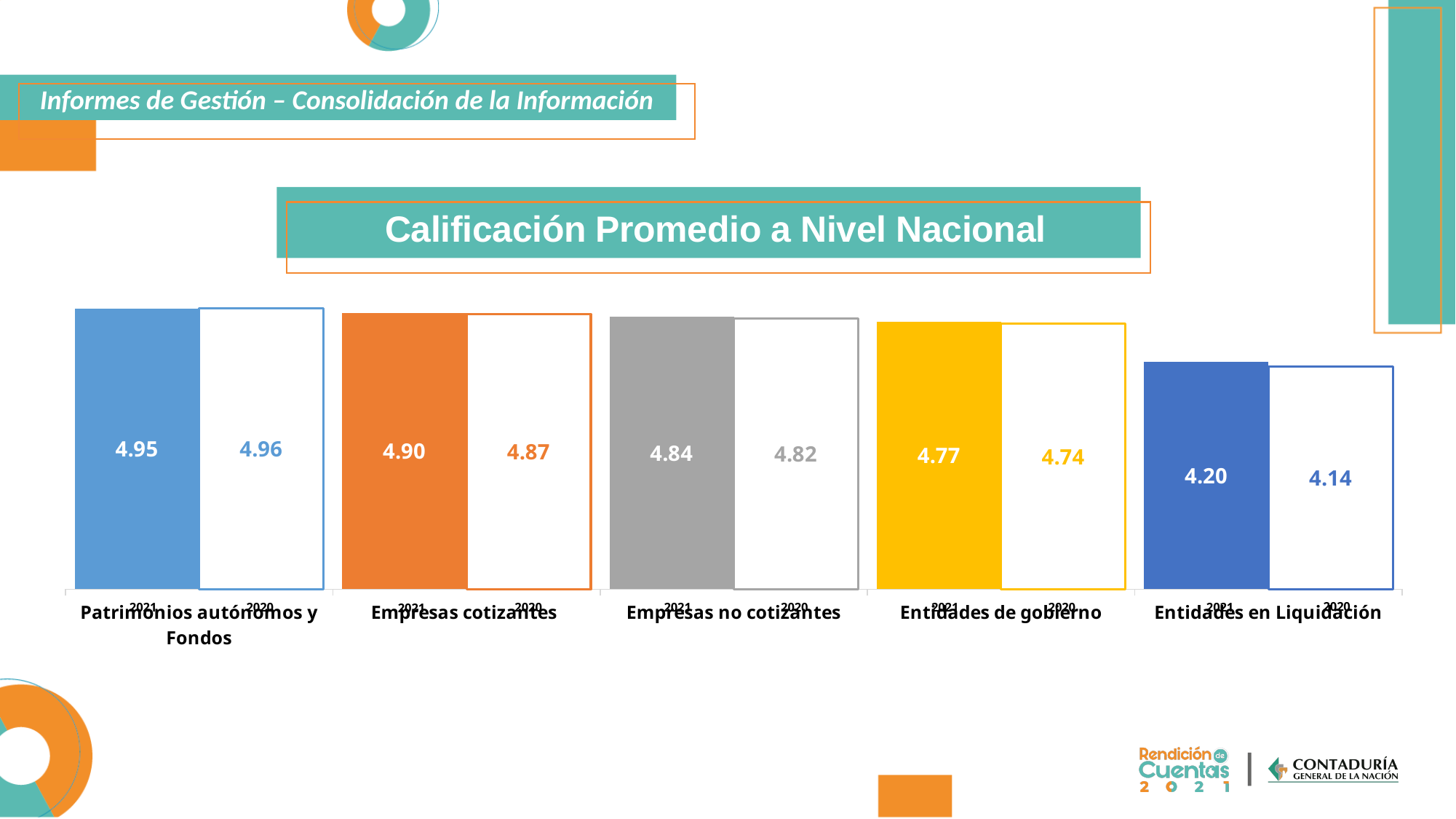
How many categories are shown on the x axis? 5 What is the 2021 value for Empresas cotizantes? 4.90 What is the difference between the 2021 values for Empresas cotizantes and Empresas no cotizantes? 0.06 What is the 2020 value for Patrimonios autónomos y Fondos? 4.96 What kind of chart is shown on the slide? Bar chart What is the 2021 value for Entidades de gobierno? 4.77 Which category has the lowest 2021 value? Entidades en Liquidación What is the title of the chart? Calificación Promedio a Nivel Nacional What is the 2020 value for Entidades en Liquidación? 4.14 What is the difference between the 2021 and 2020 values for Entidades en Liquidación? 0.06 Which category has the highest 2020 value? Patrimonios autónomos y Fondos Which is larger for Entidades de gobierno, the 2021 value or the 2020 value? 2021